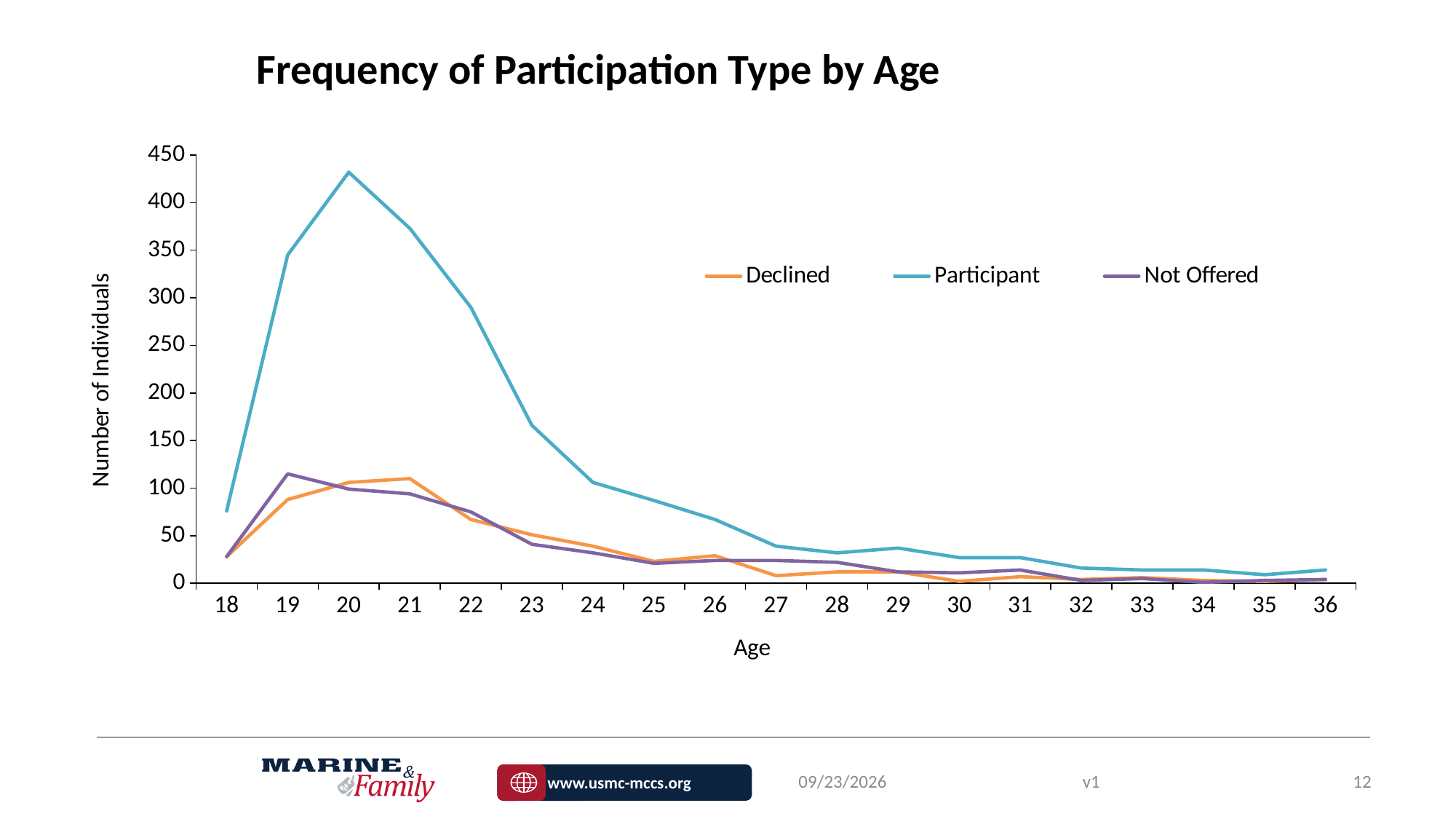
Is the Not Offered value at age 19 greater or less than 100? greater What kind of chart is shown on the slide? line chart At which age does the Participant line reach its highest value? 20 At age 19, which is larger: Not Offered or Declined? Not Offered Which series reaches the highest value on the chart? Participant Is the Declined value at age 27 greater or less than 50? less Is the Participant value at age 22 greater or less than 300? less How many series does the legend list? 3 Does the Participant line rise or fall from age 20 to age 36? fall How many ages are plotted along the x axis? 19 What is the label on the y axis? Number of Individuals